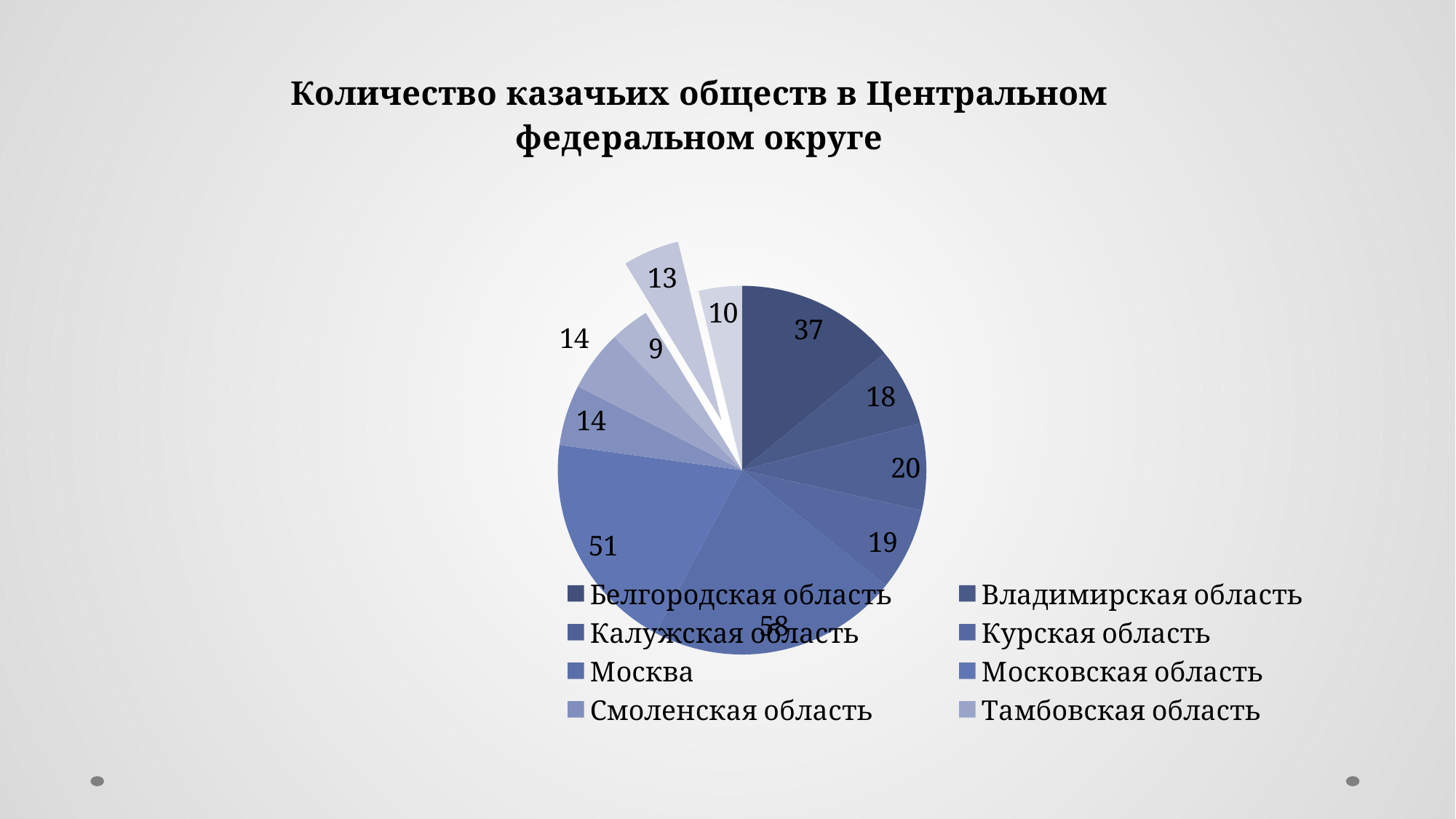
What is the value of the smallest slice in the pie chart? 9 How many slices does the pie chart have? 11 What is the value of the largest slice in the pie chart? 58 What is the value for Московская область? 51 What is the value of the slice that is pulled out (exploded) from the pie? 13 What is the title of the chart? Количество казачьих обществ в Центральном федеральном округе Which is larger, the value for Москва or the value for Московская область? Москва What kind of chart is shown on the slide? pie chart What is the value for Москва? 58 What is the difference between the values for Москва and Московская область? 7 How many entries does the legend list? 8 What is the value for Белгородская область? 37